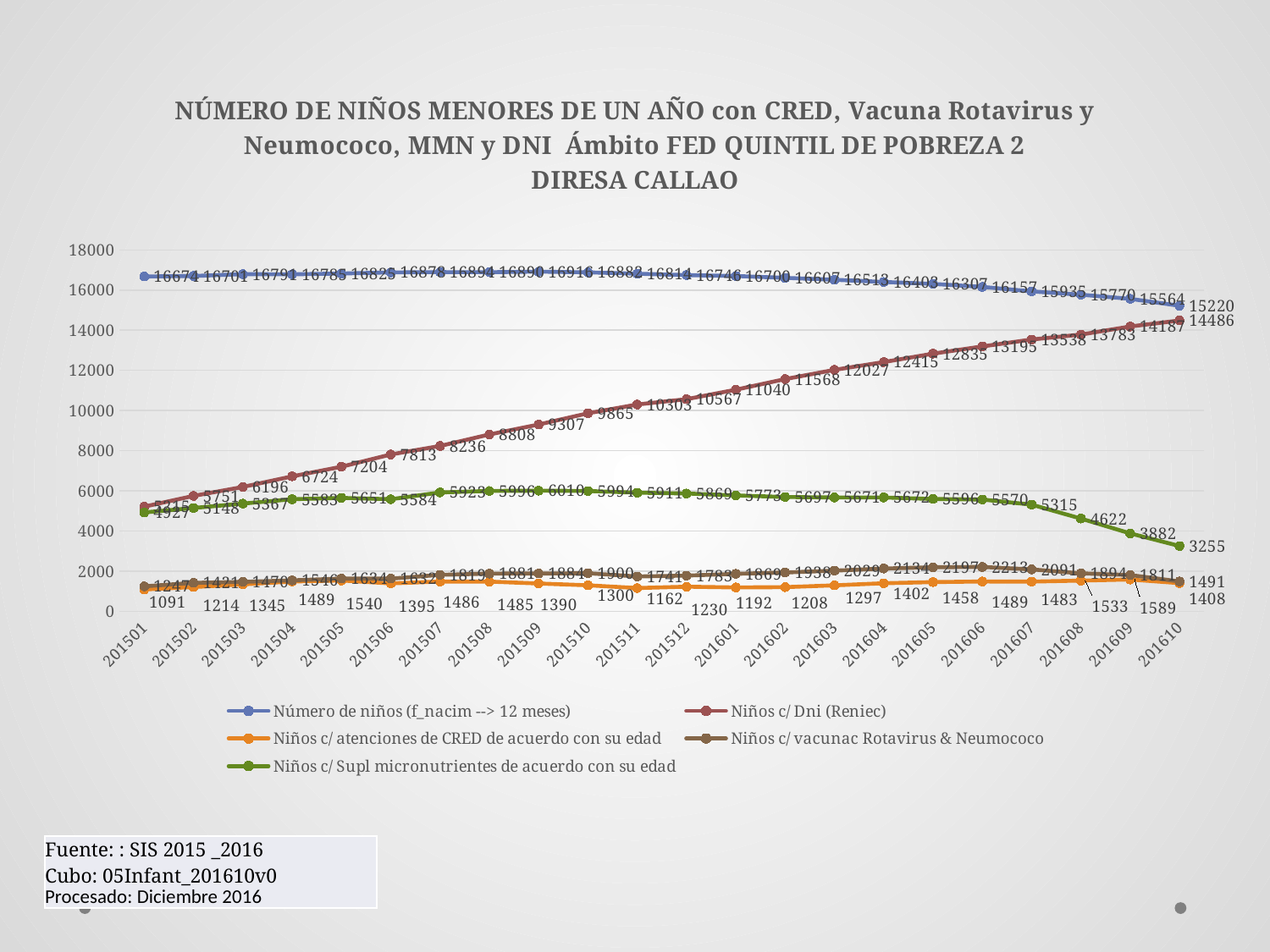
What is the value of 'Niños c/ Dni (Reniec)' for 201610? 14486 What kind of chart is shown on the slide? line chart In which period does 'Número de niños (f_nacim --> 12 meses)' reach its highest value? 201509 What is the difference between 'Número de niños (f_nacim --> 12 meses)' and 'Niños c/ Dni (Reniec)' in 201610? 734 In which period is 'Niños c/ Supl micronutrientes de acuerdo con su edad' lowest? 201610 How many series does the legend list? 5 How many time periods are plotted along the x axis? 22 Does the 'Niños c/ Dni (Reniec)' series rise or fall from 201501 to 201610? rises What is the value of 'Niños c/ Supl micronutrientes de acuerdo con su edad' for 201610? 3255 What is the value of 'Niños c/ Dni (Reniec)' for 201501? 5215 Which is larger in 201610: 'Niños c/ Supl micronutrientes de acuerdo con su edad' or 'Niños c/ vacunac Rotavirus & Neumococo'? Niños c/ Supl micronutrientes de acuerdo con su edad What is the value of 'Número de niños (f_nacim --> 12 meses)' for 201610? 15220